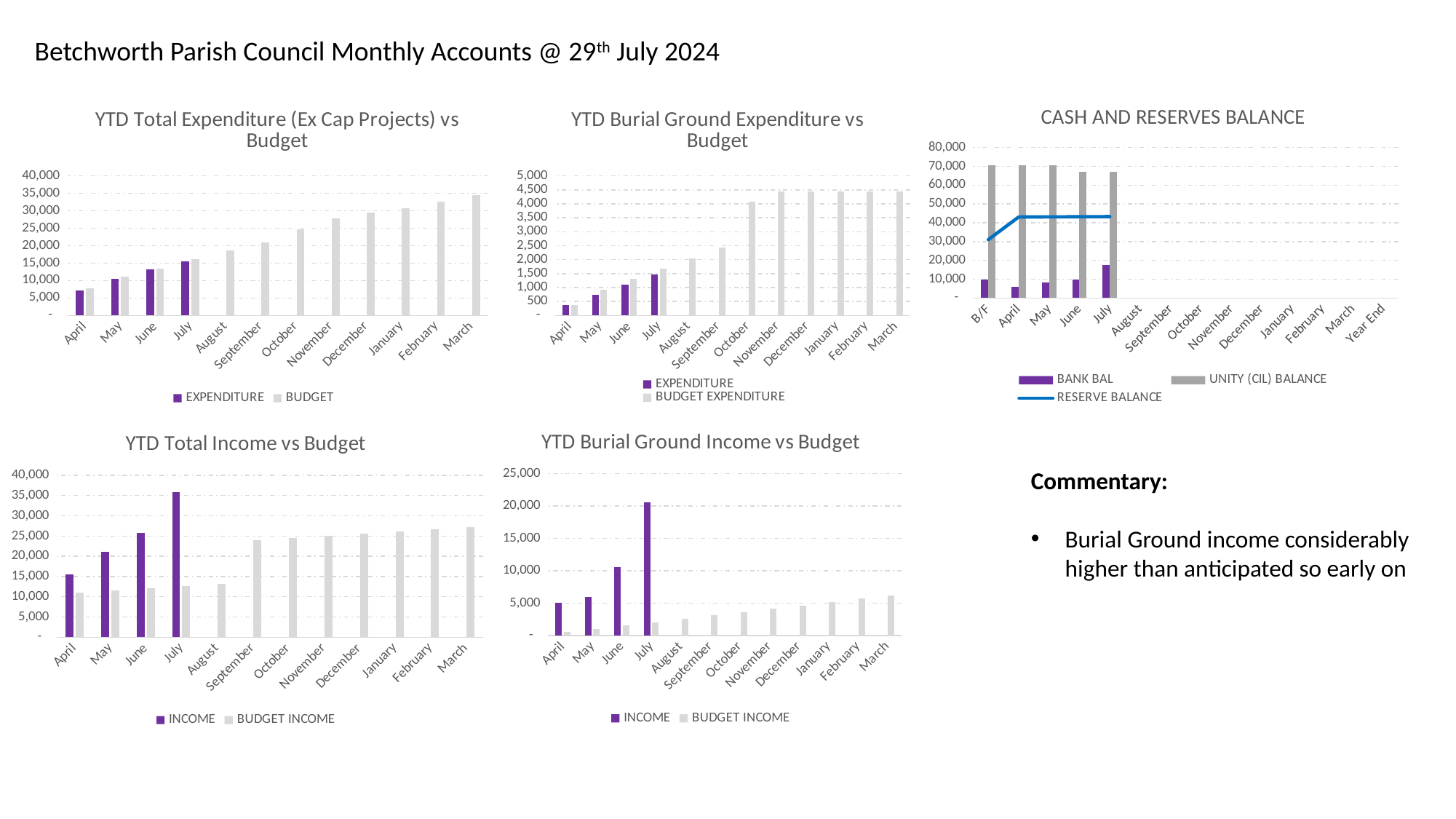
On the YTD Total Expenditure (Ex Cap Projects) vs Budget chart, do the BUDGET values rise or fall from April to March? rise On the YTD Burial Ground Expenditure vs Budget chart, is the EXPENDITURE value for July greater or less than 1,000? greater On the YTD Burial Ground Income vs Budget chart, which is larger for June: INCOME or BUDGET INCOME? INCOME What kind of chart is the YTD Burial Ground Income vs Budget chart? bar chart On the CASH AND RESERVES BALANCE chart, how many series does the legend list? 3 On the YTD Total Expenditure (Ex Cap Projects) vs Budget chart, how many series does the legend list? 2 On the CASH AND RESERVES BALANCE chart, is the UNITY (CIL) BALANCE value for B/F greater or less than 60,000? greater On the YTD Burial Ground Expenditure vs Budget chart, which series does the purple bar represent? EXPENDITURE On the YTD Total Income vs Budget chart, is the INCOME value for July greater or less than 30,000? greater On the YTD Total Income vs Budget chart, how many months are shown on the x axis? 12 On the YTD Total Income vs Budget chart, which month has the highest INCOME value? July